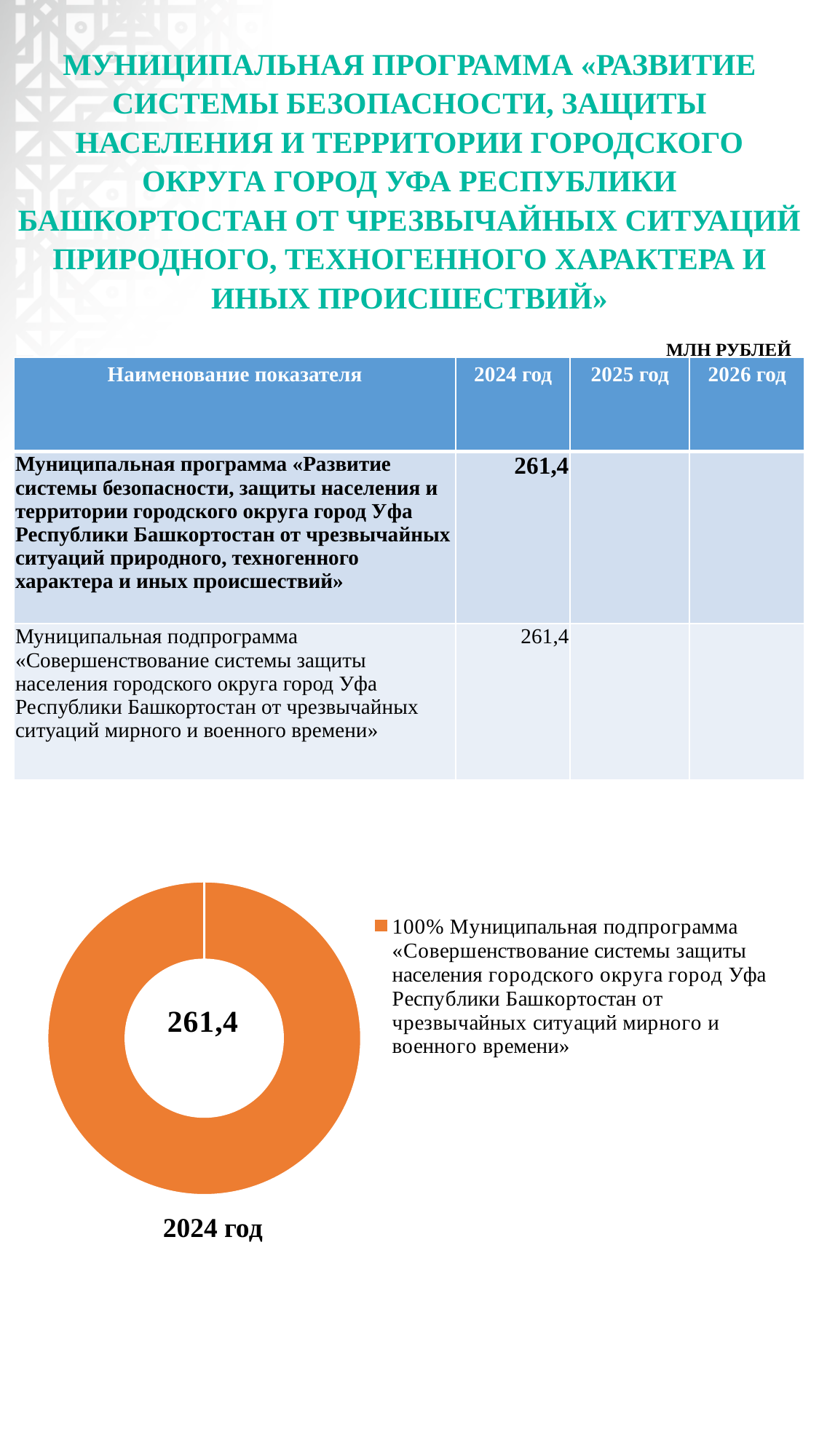
What value is printed in the centre of the doughnut chart? 261,4 What share of the doughnut chart does the subprogramme «Совершенствование системы защиты населения городского округа город Уфа Республики Башкортостан от чрезвычайных ситуаций мирного и военного времени» take? 100% What kind of chart is shown on the slide? doughnut chart How many entries does the legend of the doughnut chart list? 1 Which year is the doughnut chart labelled with? 2024 год How many slices does the doughnut chart have? 1 Is the value shown in the centre of the doughnut chart greater or less than 200? greater What colour is the single slice of the doughnut chart? orange